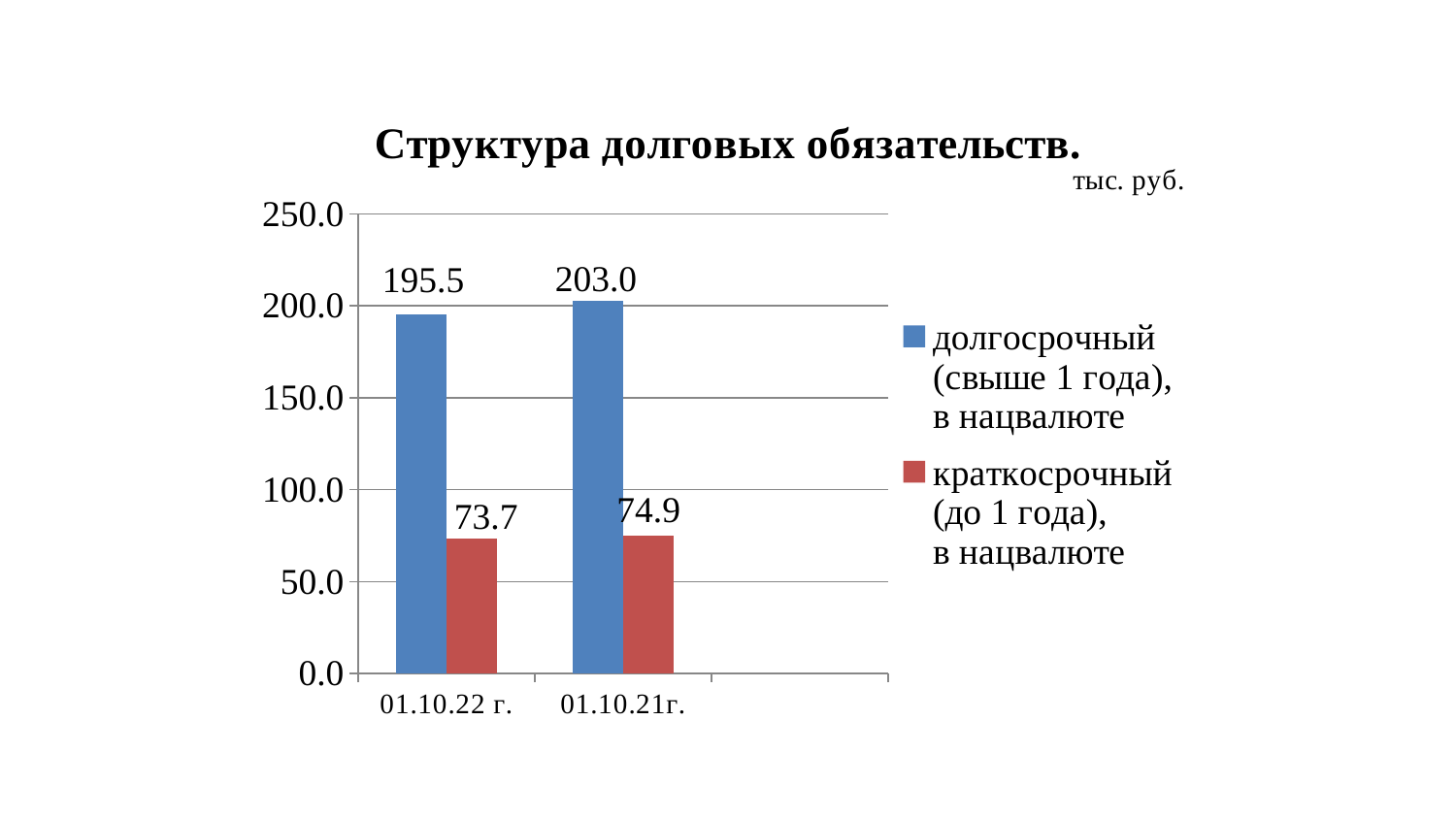
Which is larger for 01.10.21г.: долгосрочный or краткосрочный? долгосрочный What is the difference between the долгосрочный and краткосрочный values for 01.10.22 г.? 121.8 What is the value of краткосрочный (до 1 года), в нацвалюте for 01.10.21г.? 74.9 Is the value for краткосрочный (до 1 года), в нацвалюте for 01.10.22 г. greater or less than 100.0? less What is the title of the chart? Структура долговых обязательств. What is the value of краткосрочный (до 1 года), в нацвалюте for 01.10.22 г.? 73.7 How many series does the legend list? 2 Which date has the higher value for долгосрочный (свыше 1 года), в нацвалюте? 01.10.21г. What kind of chart is shown on the slide? bar chart What is the difference between the долгосрочный values for 01.10.21г. and 01.10.22 г.? 7.5 What is the value of долгосрочный (свыше 1 года), в нацвалюте for 01.10.21г.? 203.0 What is the value of долгосрочный (свыше 1 года), в нацвалюте for 01.10.22 г.? 195.5